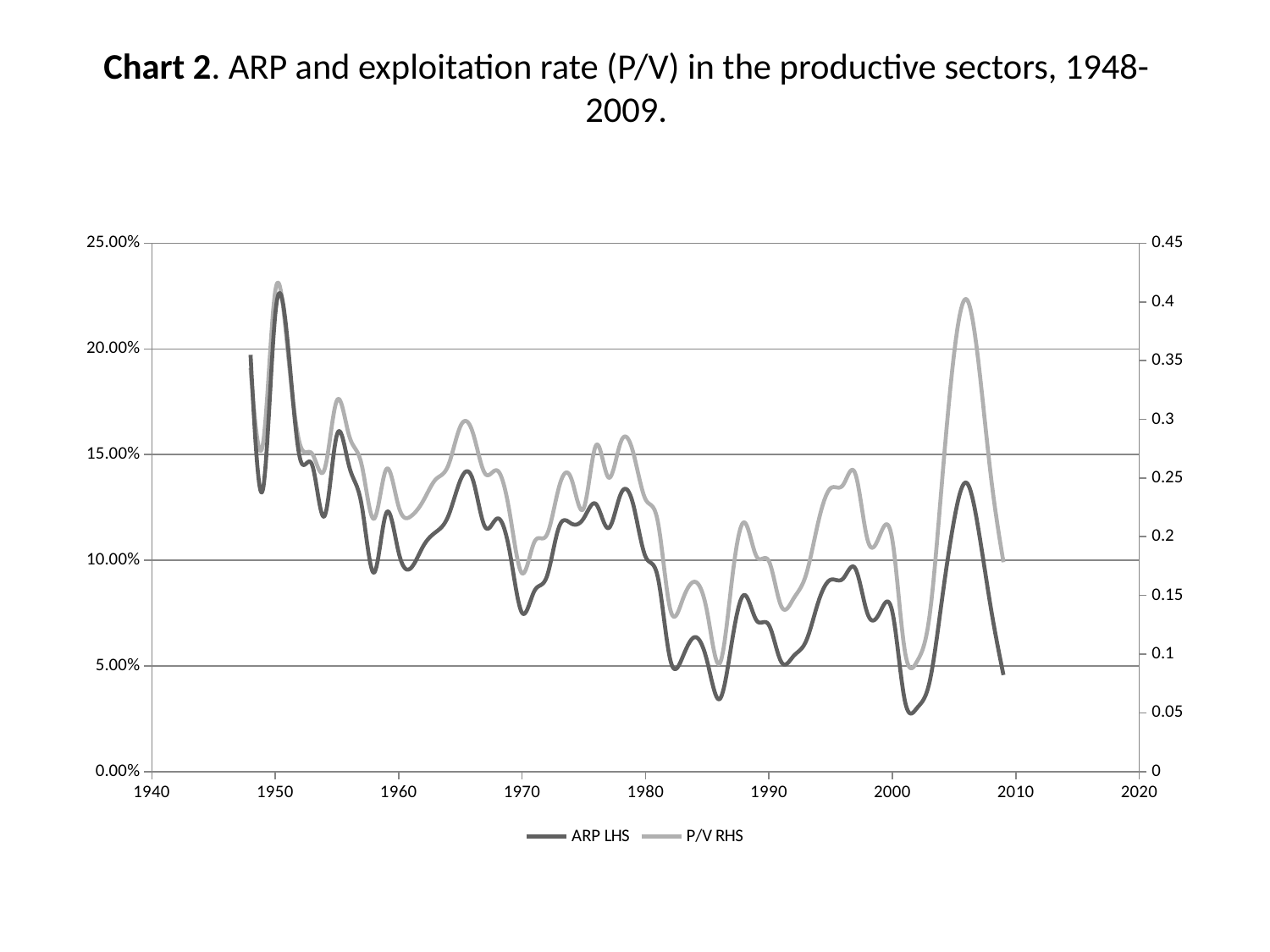
How many series does the legend list? 2 Is the peak value of P/V RHS around 1950 greater or less than 0.35? greater Is the value of ARP LHS around 2001 greater or less than 5.00%? less What are the two series named in the legend? ARP LHS and P/V RHS Is the value of ARP LHS around 1970 greater or less than 10.00%? less Which is higher for ARP LHS: the peak around 1950 or the peak around 2006? the peak around 1950 What is the title of the chart? Chart 2. ARP and exploitation rate (P/V) in the productive sectors, 1948-2009. What kind of chart is shown on the slide? line chart Overall, does the ARP LHS series rise or fall from 1948 to 2009? fall